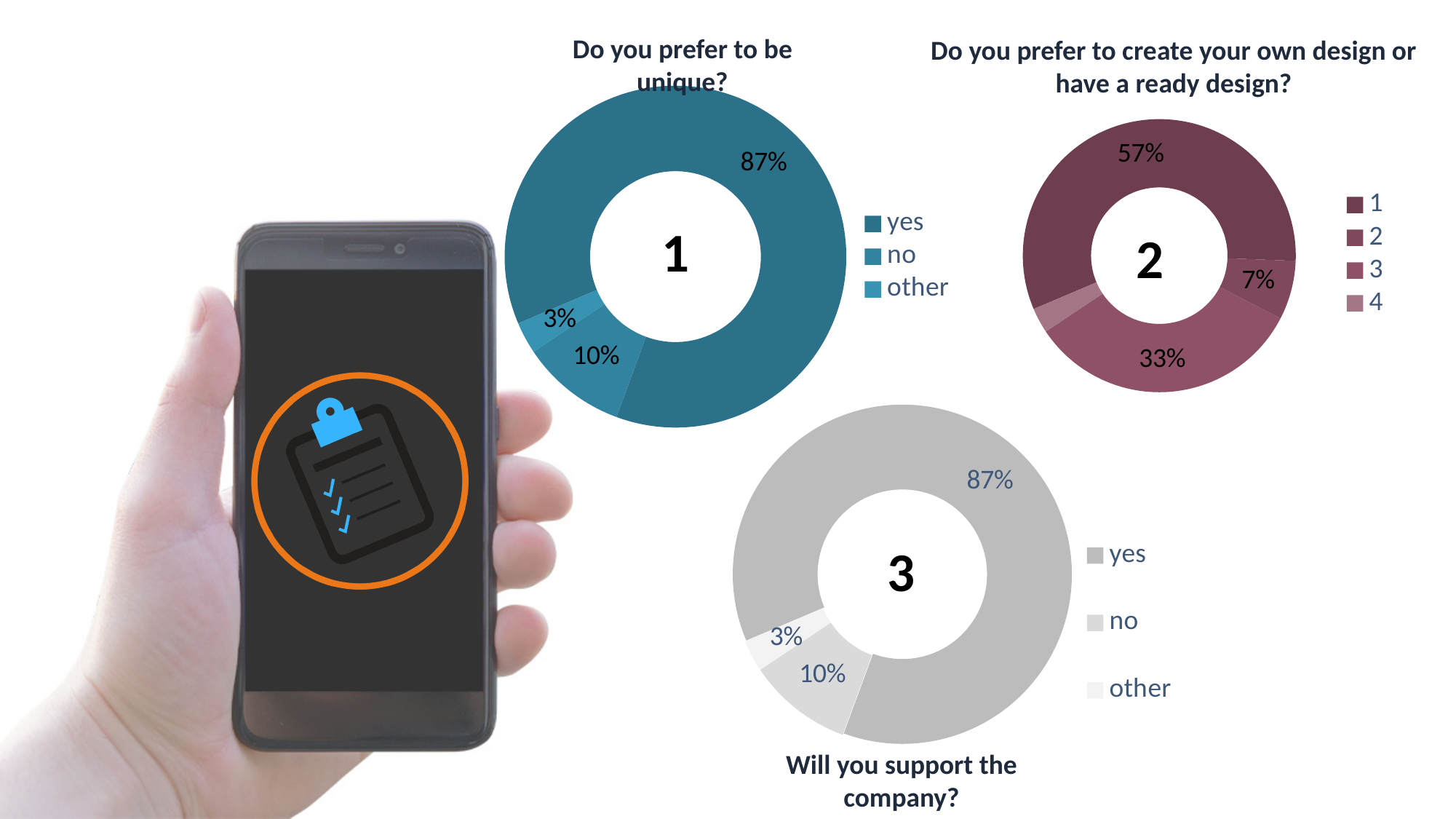
In the chart titled "Do you prefer to be unique?", what percentage answered no? 10% In the chart titled "Do you prefer to be unique?", which answer has the smallest share? other In the chart titled "Do you prefer to create your own design or have a ready design?", what is the difference between the 57% slice and the 33% slice? 24% In the chart titled "Will you support the company?", what percentage answered yes? 87% In the chart titled "Do you prefer to be unique?", what percentage answered other? 3% In the chart titled "Do you prefer to create your own design or have a ready design?", how many entries does the legend list? 4 In the chart titled "Do you prefer to be unique?", what percentage answered yes? 87% In the chart titled "Do you prefer to create your own design or have a ready design?", what is the largest percentage shown? 57% What kind of chart is the chart titled "Will you support the company?"? doughnut chart How many charts are shown on the slide? 3 In the chart titled "Do you prefer to be unique?", what is the difference between the yes and no shares? 77% In the chart titled "Will you support the company?", which is larger, the no share or the other share? no